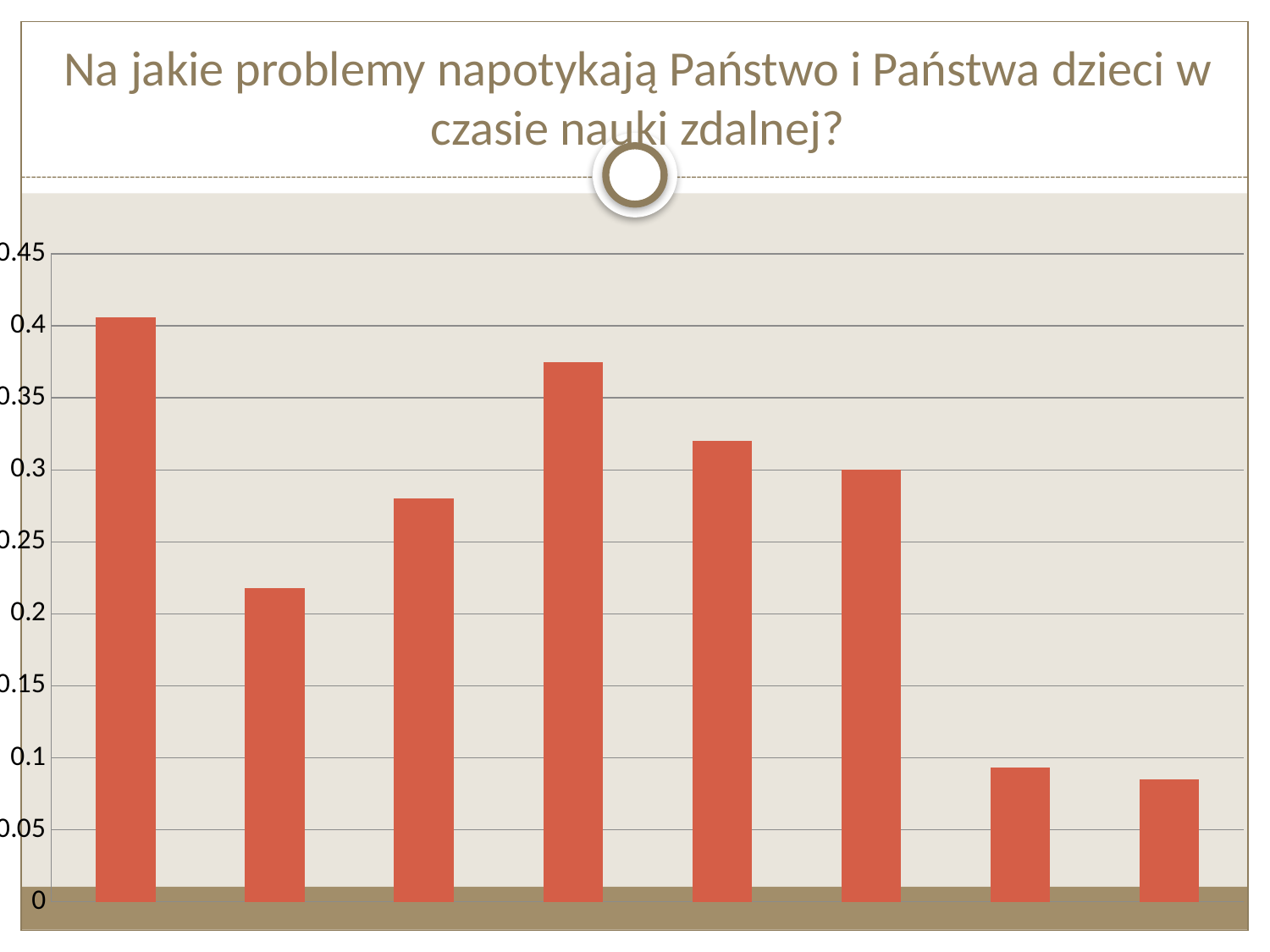
Is the value of the last (rightmost) bar greater or less than 0.1? less How many bars does the chart contain? 8 Is the value of the fourth bar from the left greater or less than 0.35? greater What is the title of the chart on the slide? Na jakie problemy napotykają Państwo i Państwa dzieci w czasie nauki zdalnej? Which bar is the tallest in the chart? the first (leftmost) bar Which is taller, the first (leftmost) bar or the fourth bar from the left? the first bar Is the value of the third bar from the left greater or less than 0.25? greater Which is taller, the second bar from the left or the third bar from the left? the third bar What kind of chart is shown on the slide? bar chart What value does the sixth bar from the left reach on the vertical axis? 0.3